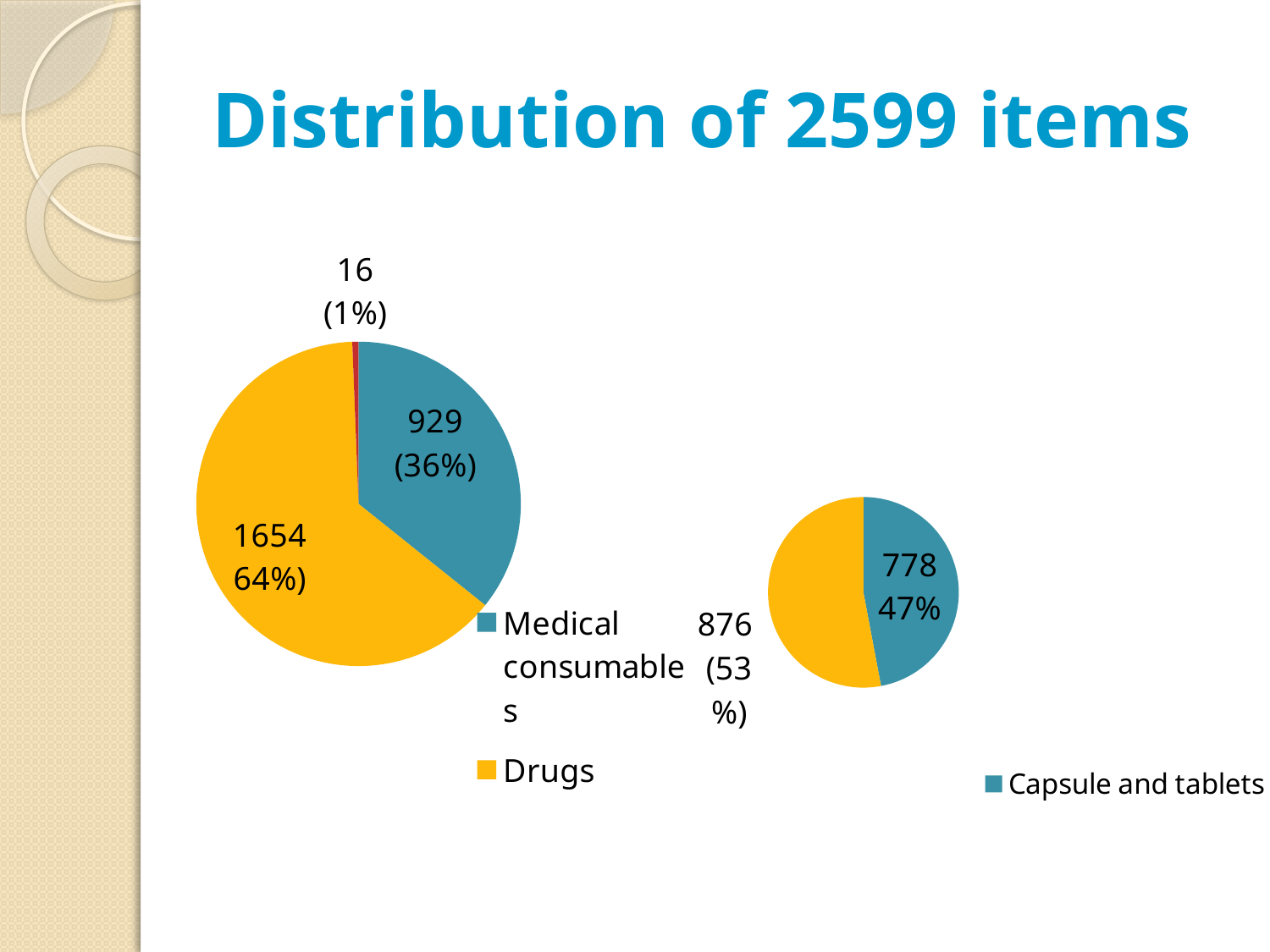
What is the title of the slide? Distribution of 2599 items In the left pie chart, which category has the largest slice? Drugs In the left pie chart, what share of the pie is Drugs? 64% In the left pie chart, what is the difference between the Drugs value and the Medical consumables value? 725 In the left pie chart, what is the value for Medical consumables? 929 In the left pie chart, what share of the pie is Medical consumables? 36% In the left pie chart, which is larger, Drugs or Medical consumables? Drugs In the right pie chart, what is the value for Capsule and tablets? 778 In the right pie chart, what share of the pie is Capsule and tablets? 47% What kind of chart is the left chart on the slide? Pie chart In the left pie chart, what is the value for Drugs? 1654 In the right pie chart, what is the value of the yellow slice? 876